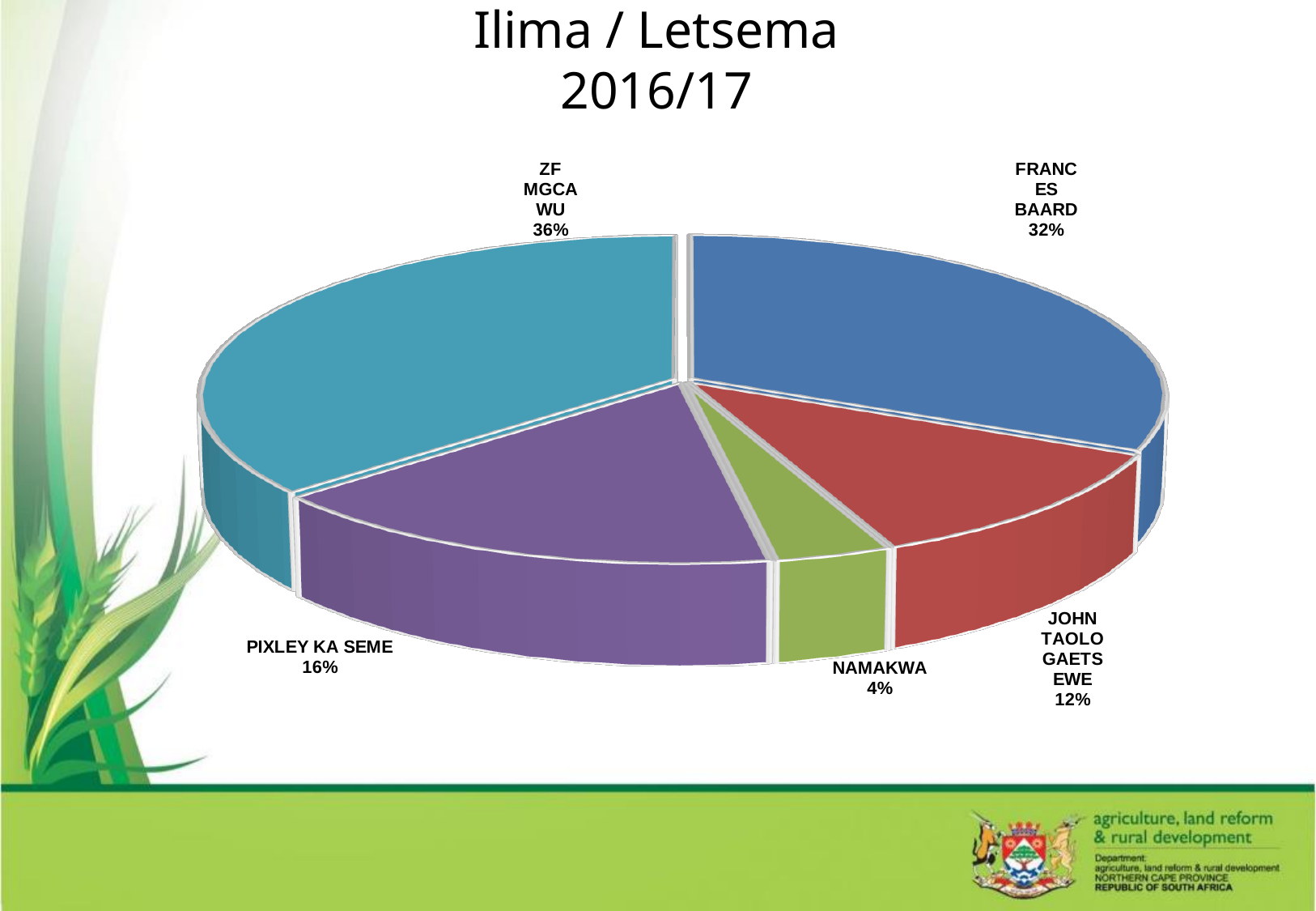
Which is larger, Pixley Ka Seme or John Taolo Gaetsewe? Pixley Ka Seme Which district has the smallest slice of the pie? Namakwa How many districts are shown in the pie chart? 5 What is the title of the chart? Ilima / Letsema 2016/17 What kind of chart is shown on the slide? Pie chart What is the value for John Taolo Gaetsewe? 12% What share does Pixley Ka Seme hold? 16% Which district has the largest slice of the pie? ZF Mgcawu What share of the pie does ZF Mgcawu hold? 36% What is the difference in percentage points between ZF Mgcawu and Frances Baard? 4 What percentage is shown for Namakwa? 4% What is the value shown for Frances Baard? 32%